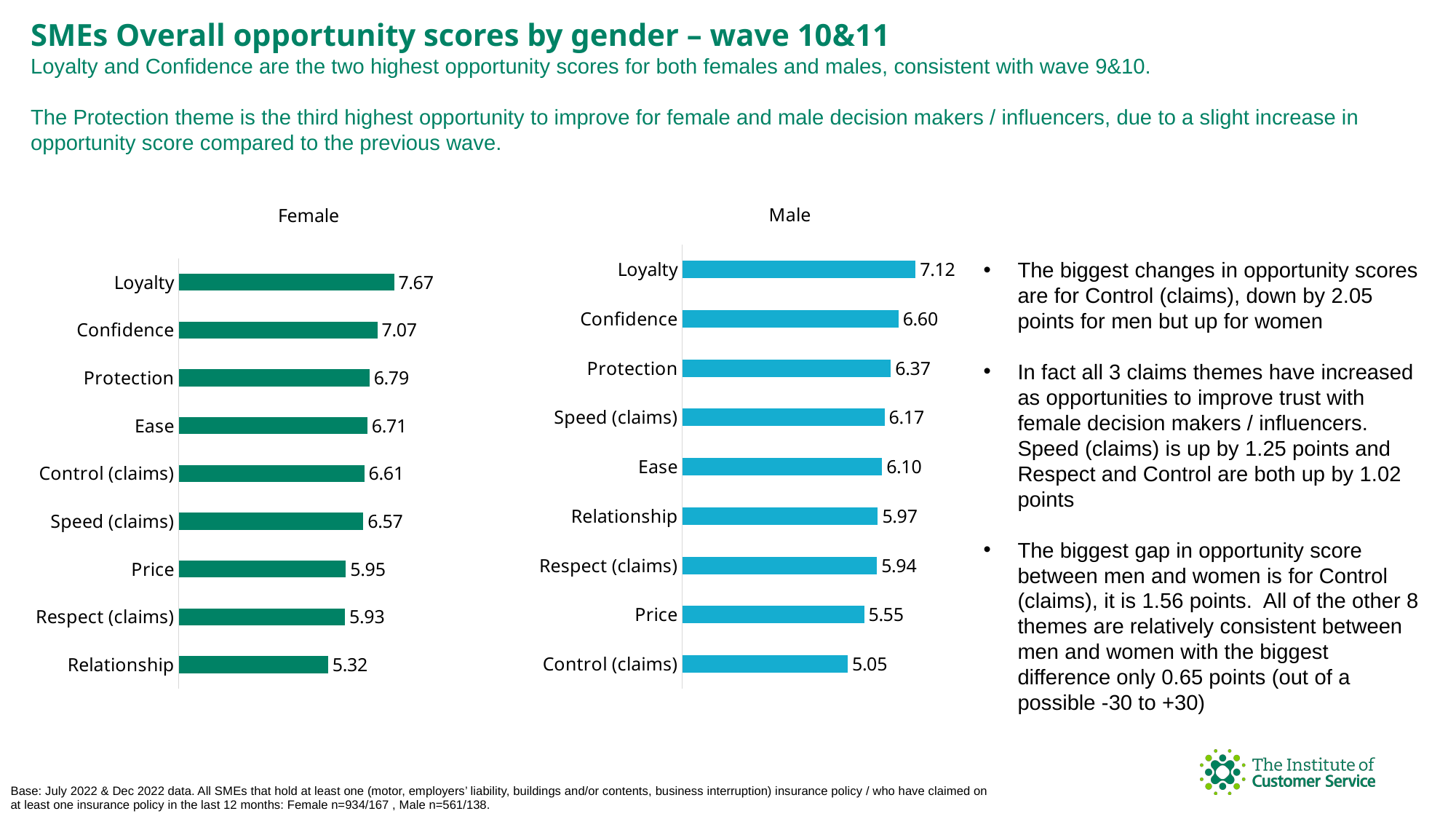
How many categories are shown in the Male chart? 9 In the Male chart, what is the opportunity score for Speed (claims)? 6.17 In the Male chart, what is the opportunity score for Relationship? 5.97 In the Female chart, which category has the lowest opportunity score? Relationship What type of chart is the Female chart? Bar chart What is the difference between the Female and Male opportunity scores for Control (claims)? 1.56 In the Male chart, what is the difference between the Loyalty and Confidence scores? 0.52 In the Male chart, which category has the lowest opportunity score? Control (claims) In the Female chart, which category has the highest opportunity score? Loyalty Which is larger: the Female score for Price or the Male score for Price? Female (5.95) In the Female chart, what is the opportunity score for Protection? 6.79 What colour are the bars in the Male chart? Light blue